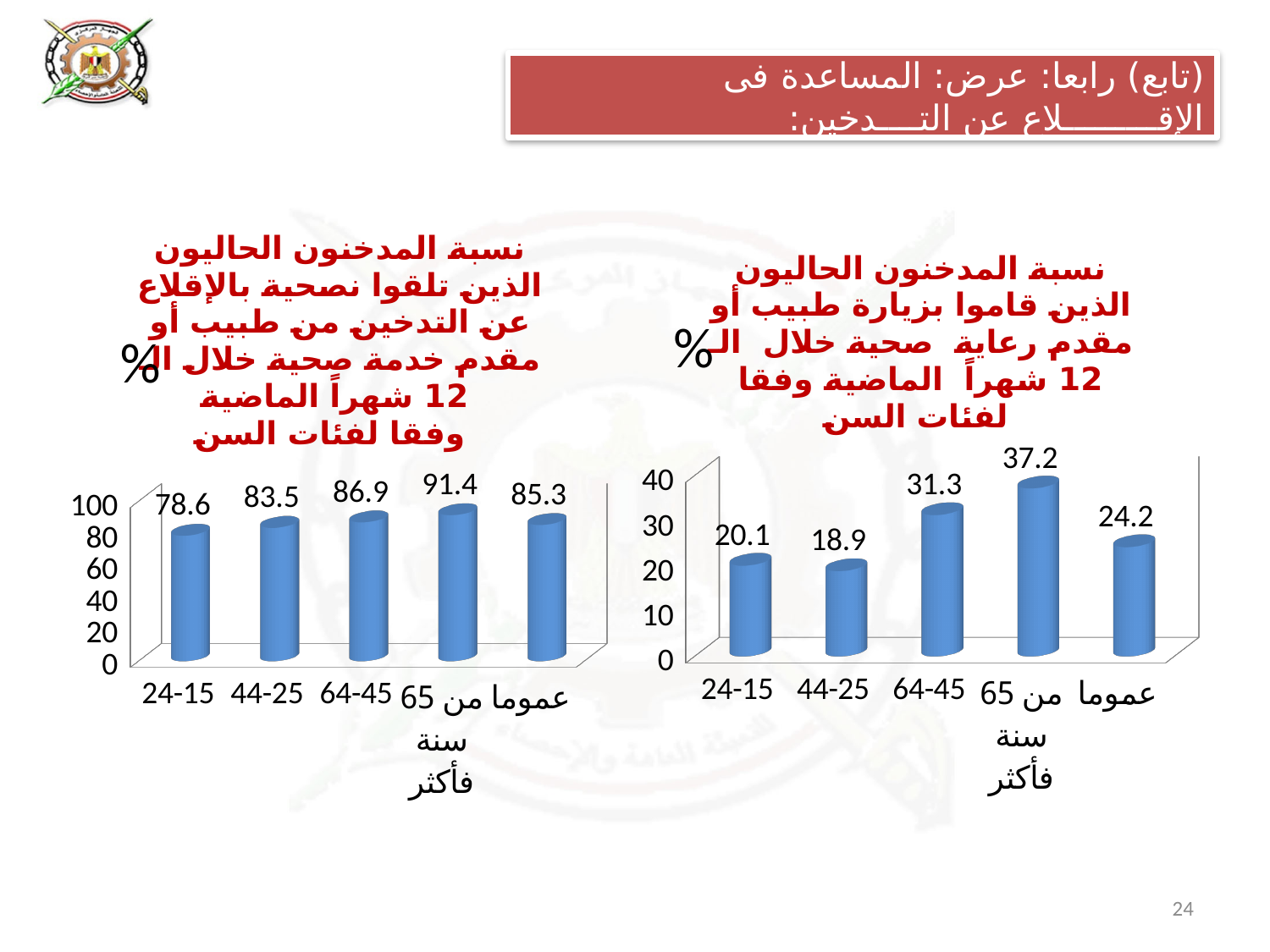
In the right chart (visited a doctor or health care provider), which age group has the highest value? 65 years and older In the right chart (visited a doctor or health care provider), what is the value for the 15-24 age group? 20.1 In the left chart (advised to quit smoking), which age group has the lowest value? 15-24 In the left chart (advised to quit smoking), which age group has the highest value? 65 years and older In the right chart (visited a doctor or health care provider), which age group has the lowest value? 25-44 In the left chart (advised to quit smoking), what is the overall (عموما) value? 85.3 In the left chart (current smokers advised to quit smoking by a doctor or health service provider), what is the value for the 45-64 age group? 86.9 How many categories are shown on the x axis of the right chart (visited a doctor or health care provider)? 5 In the right chart (current smokers who visited a doctor or health care provider in the past 12 months), what is the value for the 65 years and older age group? 37.2 What type of chart is the left chart (advised to quit smoking)? Bar chart In the left chart (advised to quit smoking), what is the difference between the 65 years and older group and the 15-24 group? 12.8 In the right chart (visited a doctor or health care provider), what is the difference between the 45-64 group and the 25-44 group? 12.4